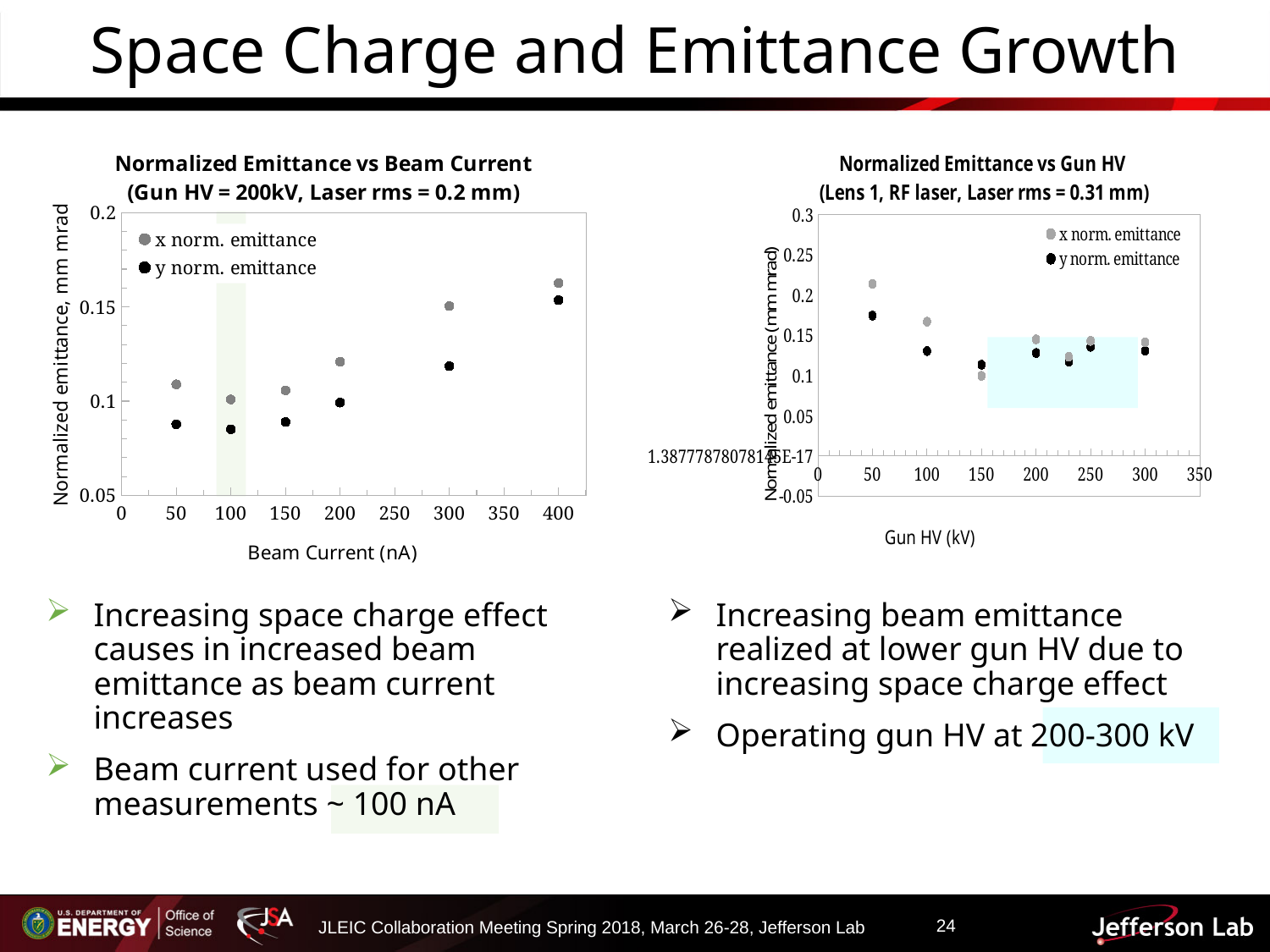
In the left chart, 'Normalized Emittance vs Beam Current', is the y norm. emittance at 50 nA greater or less than 0.1? less In the right chart, 'Normalized Emittance vs Gun HV', at which gun HV is the x norm. emittance highest? 50 kV What kind of chart is the left chart, 'Normalized Emittance vs Beam Current'? scatter chart In the left chart, 'Normalized Emittance vs Beam Current', at 300 nA, which is larger: x norm. emittance or y norm. emittance? x norm. emittance What is the x-axis title of the right chart, 'Normalized Emittance vs Gun HV'? Gun HV (kV) In the right chart, 'Normalized Emittance vs Gun HV', how many data points are plotted for the y norm. emittance series? 7 In the left chart, 'Normalized Emittance vs Beam Current', how many data points are plotted for the x norm. emittance series? 6 In the right chart, 'Normalized Emittance vs Gun HV', is the y norm. emittance at 50 kV greater or less than 0.15? greater In the right chart, 'Normalized Emittance vs Gun HV', does the x norm. emittance rise or fall as gun HV increases from 50 kV to 150 kV? fall In the left chart, 'Normalized Emittance vs Beam Current', at which beam current is the x norm. emittance highest? 400 nA In the left chart, 'Normalized Emittance vs Beam Current', how many series does the legend list? 2 In the left chart, 'Normalized Emittance vs Beam Current', does the y norm. emittance rise or fall as beam current increases from 200 nA to 400 nA? rise